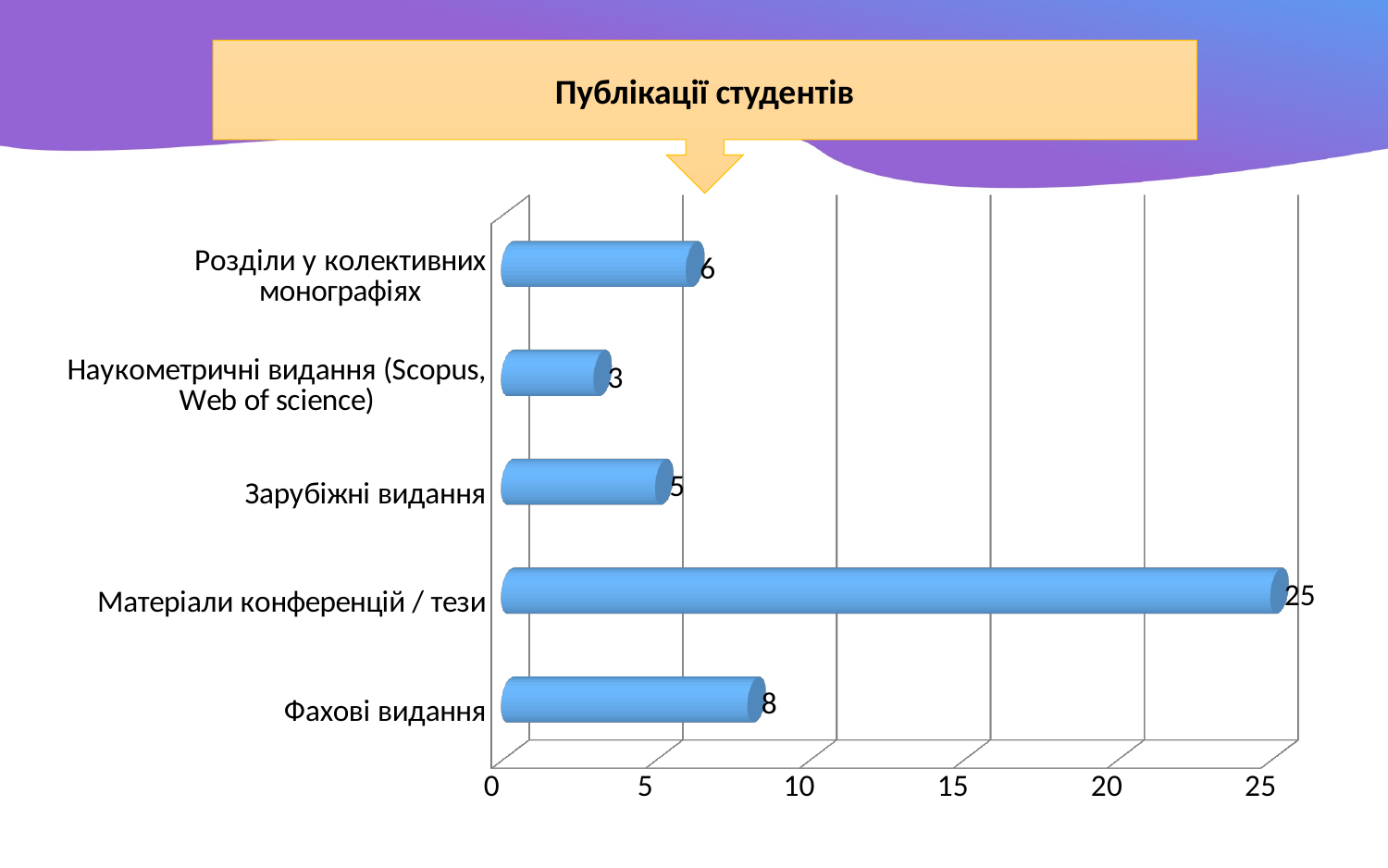
Which category has the lowest value? Наукометричні видання (Scopus, Web of science) What kind of chart is shown on the slide? bar chart Which category has the highest value? Матеріали конференцій / тези What is the value for Наукометричні видання (Scopus, Web of science)? 3 What is the title shown above the chart? Публікації студентів What is the value for Фахові видання? 8 What is the value for Матеріали конференцій / тези? 25 How many categories are shown in the chart? 5 What is the difference between the values for Матеріали конференцій / тези and Фахові видання? 17 Which is larger, the value for Розділи у колективних монографіях or the value for Зарубіжні видання? Розділи у колективних монографіях What is the value for Розділи у колективних монографіях? 6 What is the value for Зарубіжні видання? 5